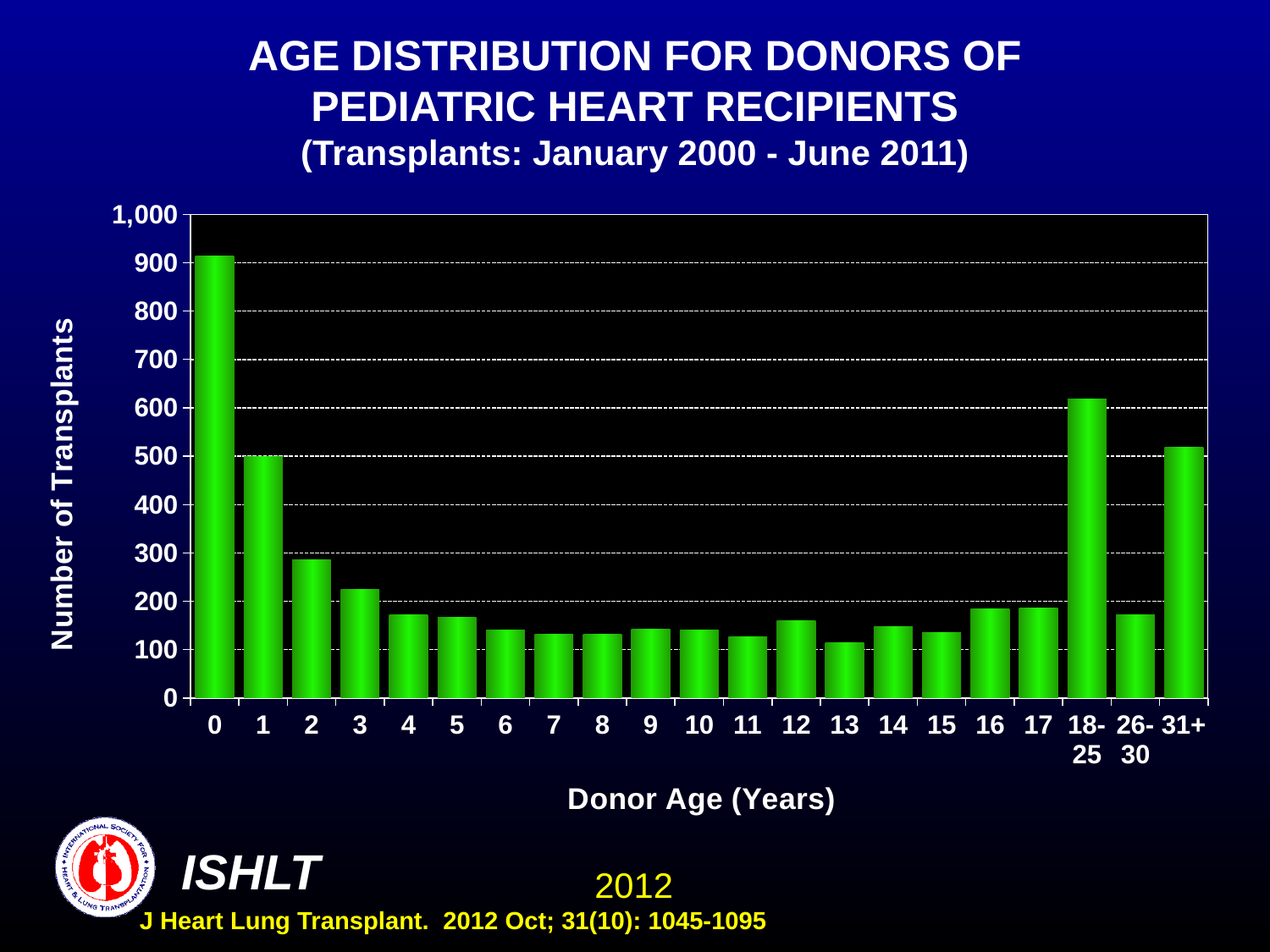
What is the title of the y axis? Number of Transplants Is the number of transplants for donor age 2 greater or less than 300? less Which donor age category has the highest number of transplants? 0 Is the number of transplants for donor age 18-25 greater or less than 600? greater What kind of chart is shown on the slide? bar chart Which has more transplants: donor age 2 or donor age 26-30? 2 How many donor age categories are shown on the x axis? 21 Which has more transplants: donor age 18-25 or donor age 31+? 18-25 Is the number of transplants for donor age 1 greater or less than 400? greater Do the number of transplants rise or fall from donor age 0 to donor age 5? fall